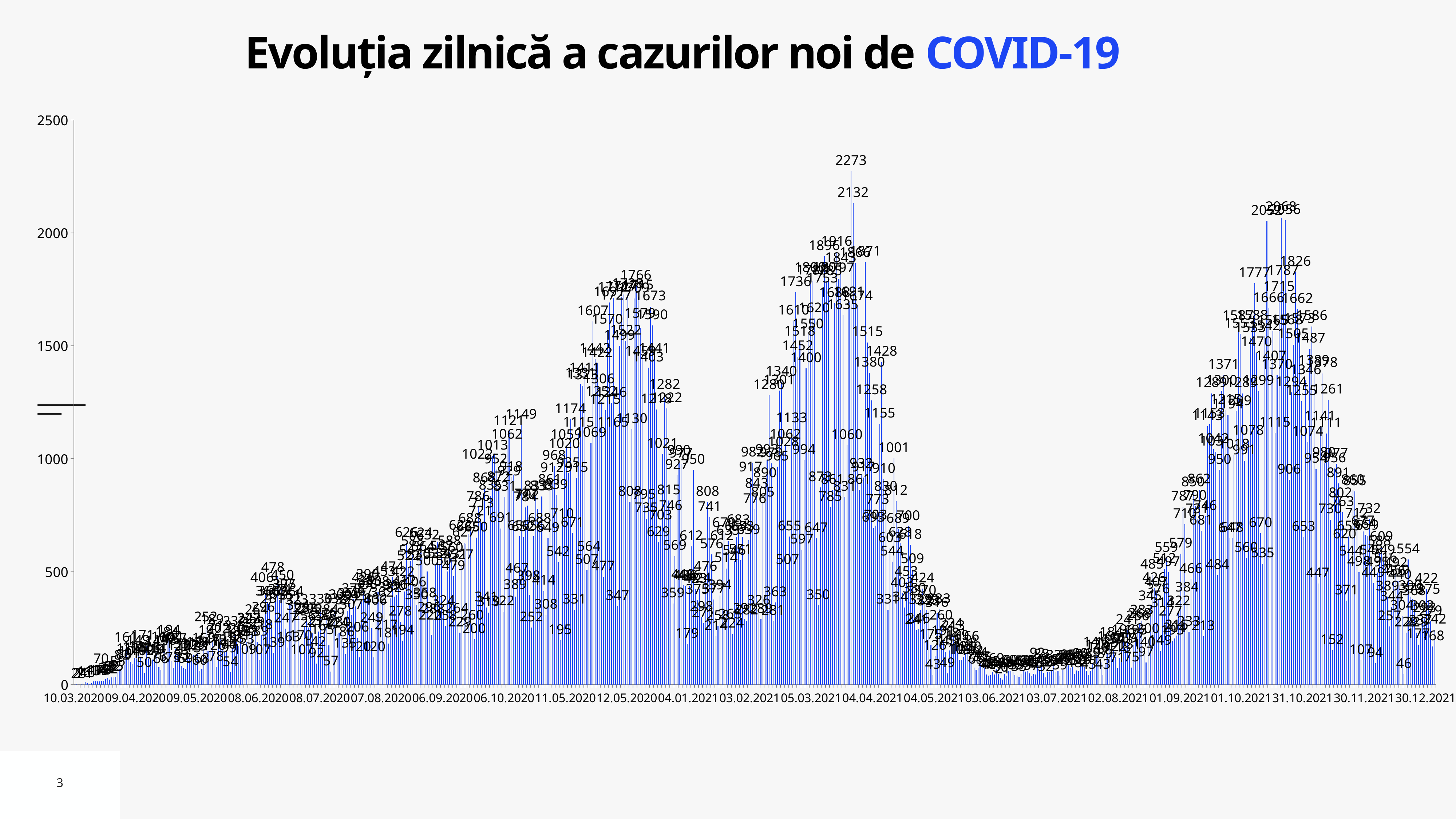
What is the title of the chart? Evoluția zilnică a cazurilor noi de COVID-19 What is the highest tick shown on the vertical axis? 2500 What is the difference between the two highest labelled values, 2273 and 2132? 141 Between 03.07.2021 and 01.10.2021, do the values generally rise or fall? rise What is the first date shown on the horizontal axis? 10.03.2020 What kind of chart is shown on the slide? bar chart What is the last date shown on the horizontal axis? 30.12.2021 Is the highest value on the chart greater or less than 2000? greater What is the highest daily value labelled on the chart? 2273 Are the values around 03.07.2021 greater or less than 500? less Which is larger, the peak value 2273 or the value 1766? 2273